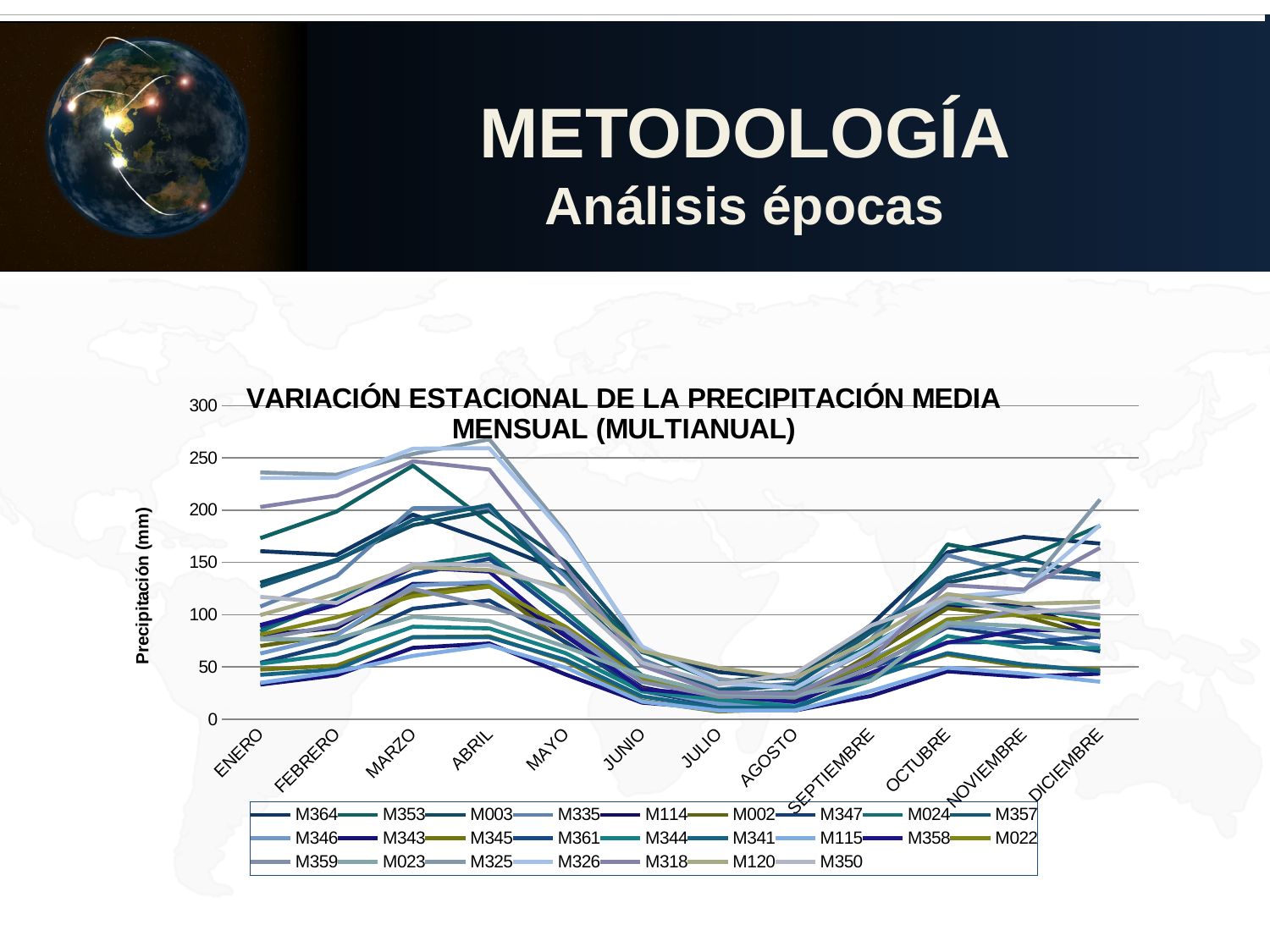
How many series does the legend list? 25 What is the highest value shown on the vertical axis? 300 Is the highest value reached by any line in AGOSTO greater or less than 50? less Which is the first month shown on the x axis? ENERO Do the lines generally rise or fall from ABRIL to JULIO? fall Do the lines generally rise or fall from AGOSTO to OCTUBRE? rise How many months are shown along the x axis? 12 What is the title of the chart? VARIACIÓN ESTACIONAL DE LA PRECIPITACIÓN MEDIA MENSUAL (MULTIANUAL) Is the highest value reached by any line in JULIO greater or less than 100? less Is the highest value reached by any line in ABRIL greater or less than 250? greater What kind of chart is shown on the slide? line chart